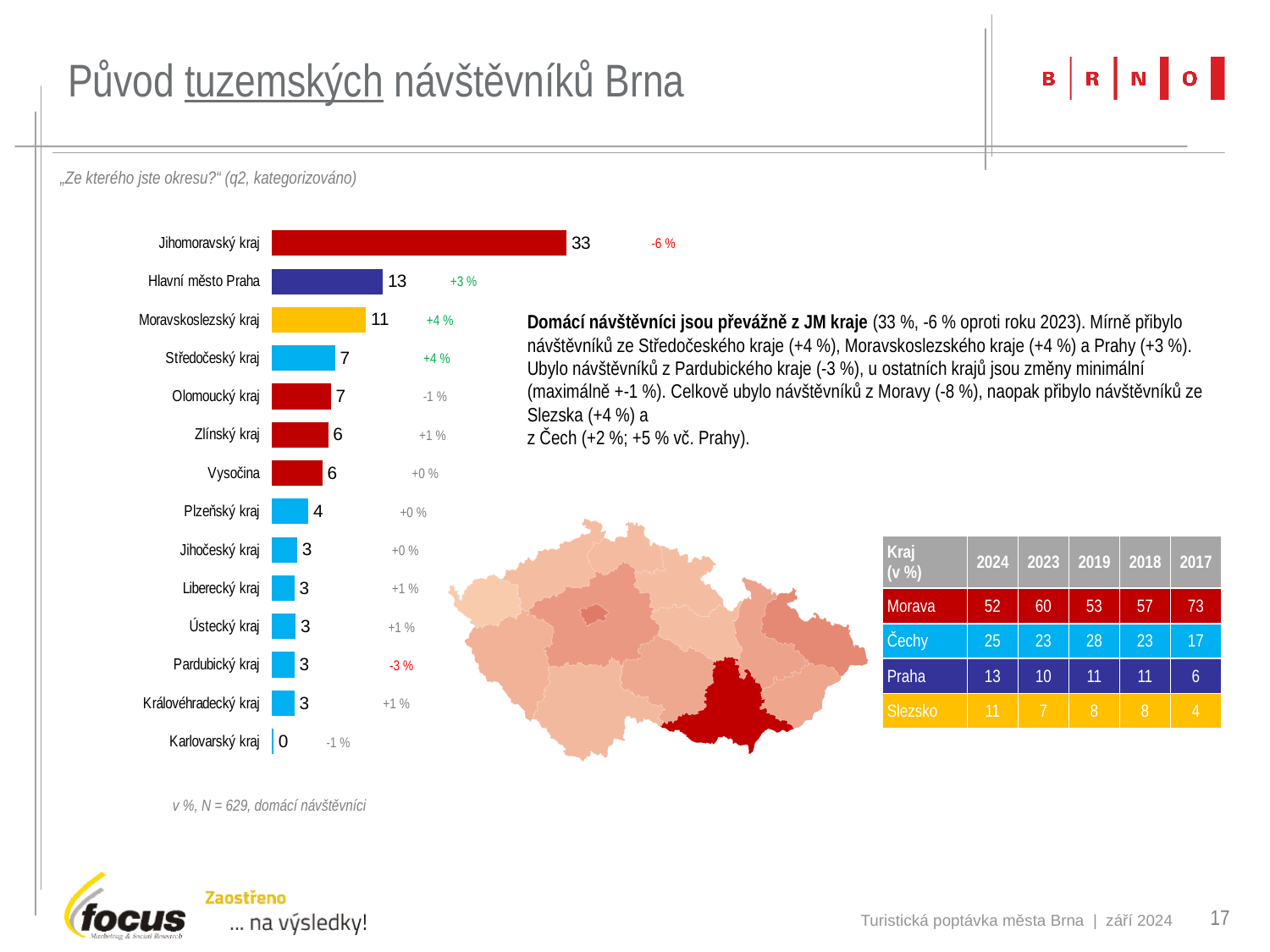
How many regions (categories) are shown in the bar chart? 14 What colour is the bar for Jihomoravský kraj? Red What is the value for Jihomoravský kraj in the bar chart? 33 Which region has the highest value in the bar chart? Jihomoravský kraj What is the value for Plzeňský kraj in the bar chart? 4 What change versus the previous year is printed next to the Pardubický kraj bar? -3 % What is the value for Moravskoslezský kraj in the bar chart? 11 Which is larger in the bar chart: the value for Moravskoslezský kraj or the value for Zlínský kraj? Moravskoslezský kraj What is the difference between the values for Jihomoravský kraj and Hlavní město Praha? 20 What kind of chart is used to show the origin of domestic visitors? Bar chart What is the value for Hlavní město Praha in the bar chart? 13 Which region has the lowest value in the bar chart? Karlovarský kraj